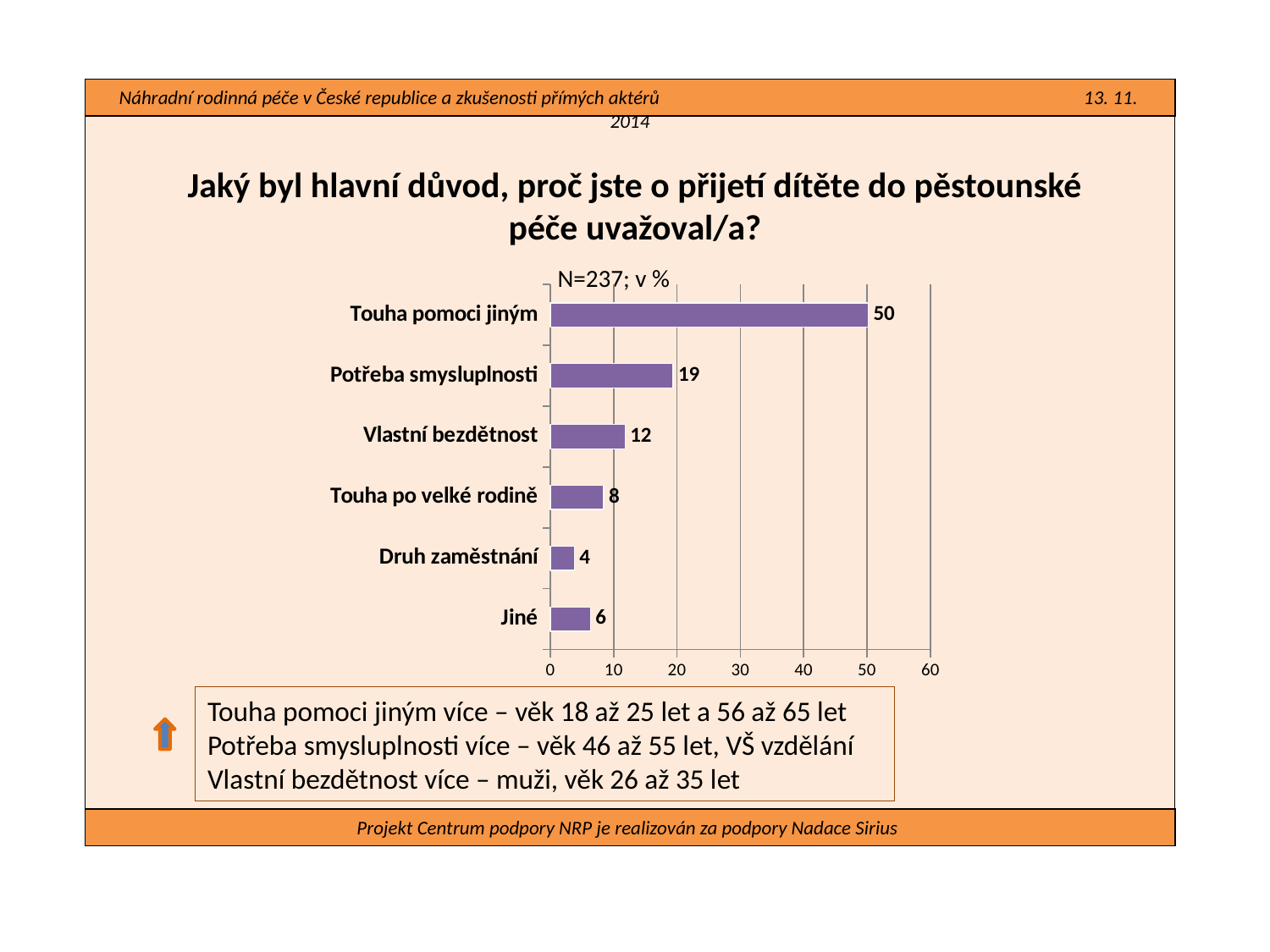
What is the sample size noted above the chart? N=237 Which category has the highest value? Touha pomoci jiným What is the value for Potřeba smysluplnosti? 19 What kind of chart is shown on the slide? bar chart What is the difference between the values for Touha pomoci jiným and Potřeba smysluplnosti? 31 Which category has the lowest value? Druh zaměstnání What is the value for Vlastní bezdětnost? 12 Which is larger, the value for Touha po velké rodině or the value for Jiné? Touha po velké rodině What is the value for Touha pomoci jiným? 50 What is the value for Druh zaměstnání? 4 How many categories are shown in the chart? 6 Is the value for Vlastní bezdětnost greater or less than 10? greater